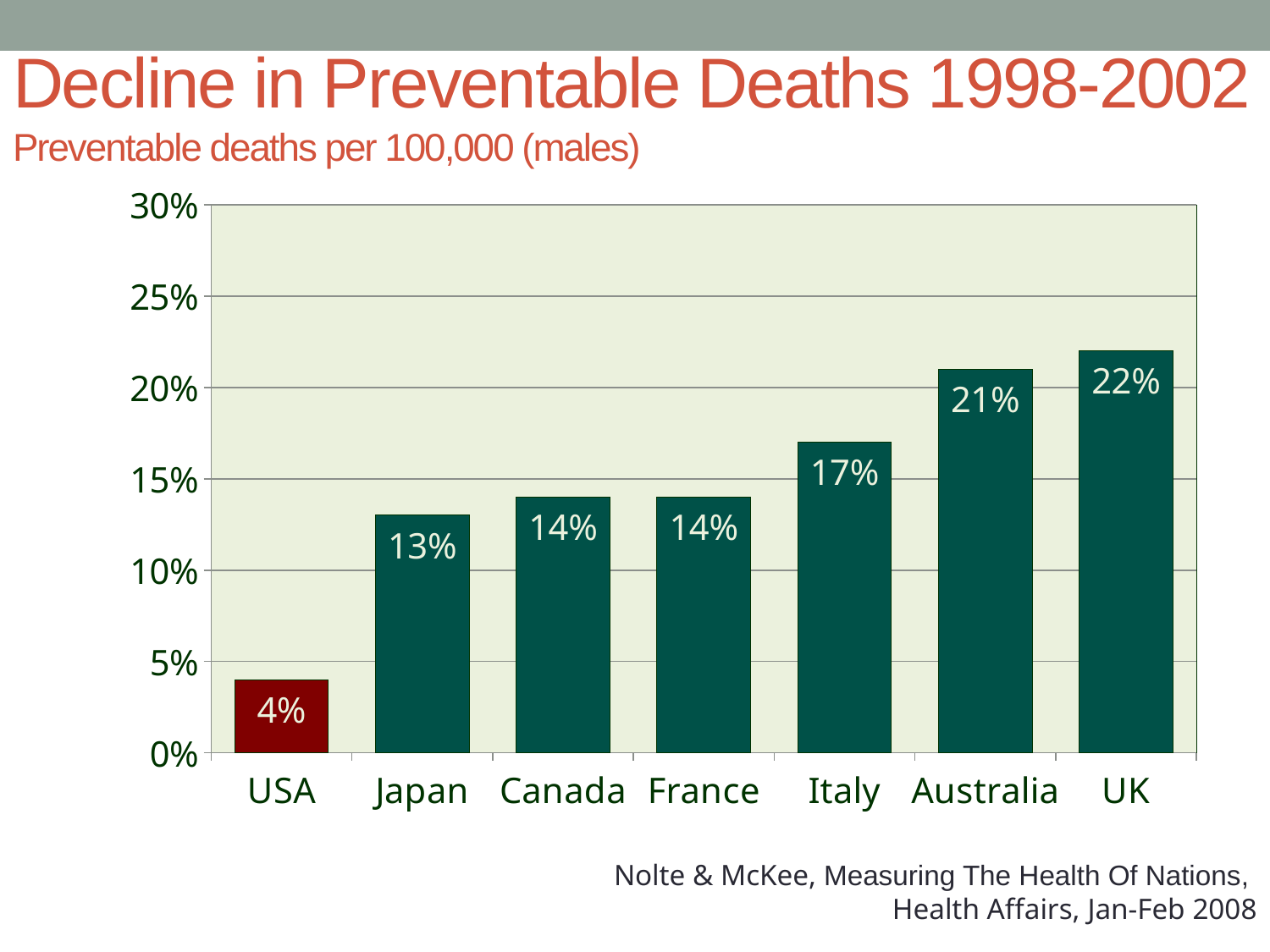
What is the difference between the values for the UK and the USA? 18% What is the value for Australia? 21% Which is larger, the value for Australia or the value for Italy? Australia How many countries are shown on the chart? 7 What is the value for the USA? 4% What is the difference between the values for Italy and Japan? 4% Which bar is shown in a different colour from the others? USA Is the value for Japan greater or less than 10%? greater What kind of chart is shown on the slide? bar chart What is the value for Italy? 17% Which country has the highest value? UK Which country has the lowest value? USA